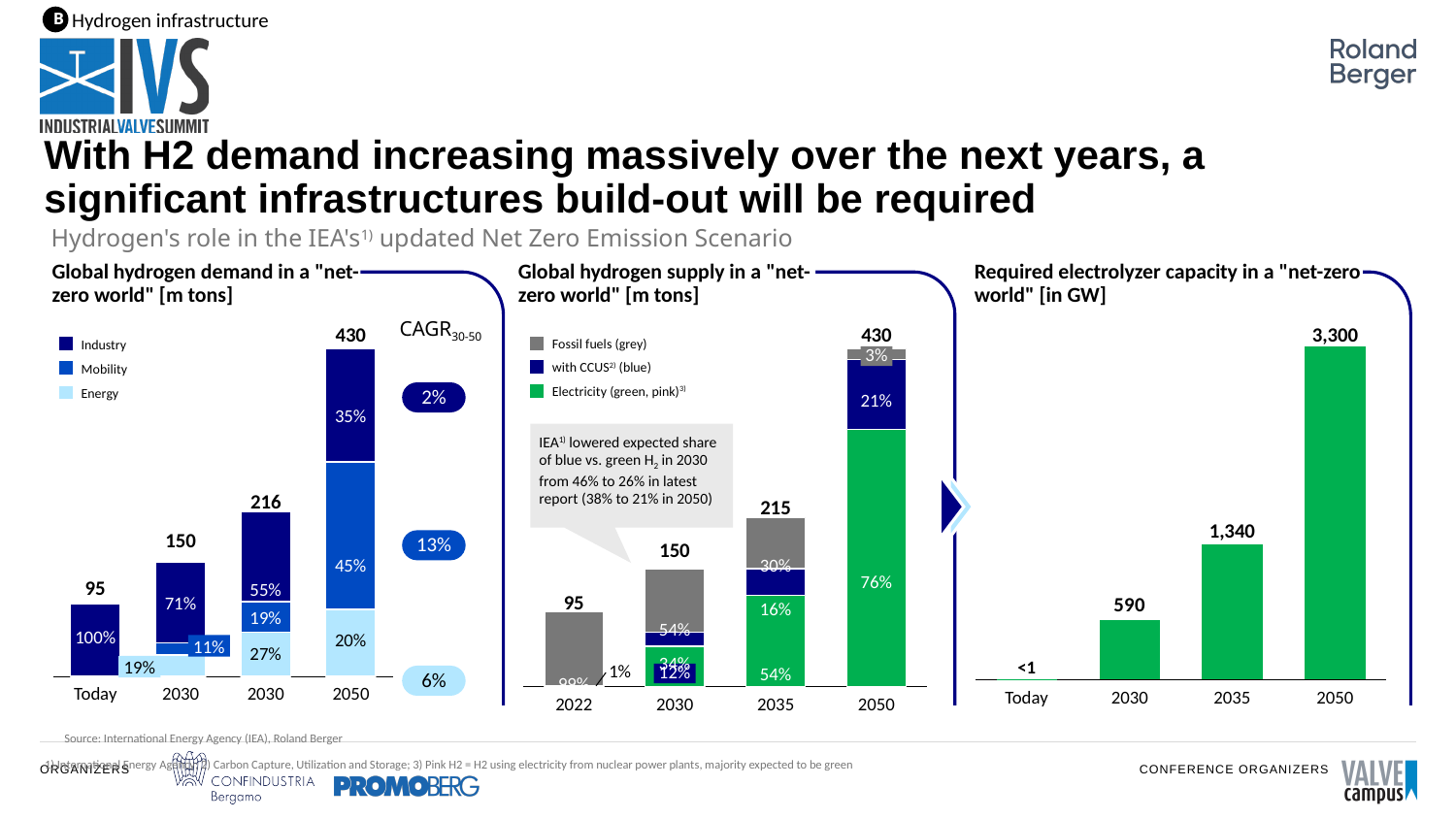
In the 'Global hydrogen demand in a net-zero world' chart, how many series does the legend list? 3 In the 'Required electrolyzer capacity in a net-zero world' chart, which year has the highest value? 2050 In the 'Global hydrogen demand in a net-zero world' chart, what is the total value for 2050? 430 In the 'Global hydrogen supply in a net-zero world' chart, what is the total value for 2035? 215 In the 'Required electrolyzer capacity in a net-zero world' chart, what is the value for 2035? 1,340 In the 'Global hydrogen demand in a net-zero world' chart, what is the total value for Today? 95 In the 'Required electrolyzer capacity in a net-zero world' chart, what is the difference between the 2050 and 2030 values? 2,710 In the 'Global hydrogen demand in a net-zero world' chart, what is the CAGR 30-50 shown for Mobility? 13% In the 'Global hydrogen demand in a net-zero world' chart, what share of the 2050 bar is Mobility? 45% What kind of chart is the 'Required electrolyzer capacity in a net-zero world' chart? Bar chart In the 'Global hydrogen supply in a net-zero world' chart, what is the difference between the 2050 total and the 2022 total? 335 In the 'Global hydrogen supply in a net-zero world' chart, what share of the 2050 bar is Electricity (green)? 76%